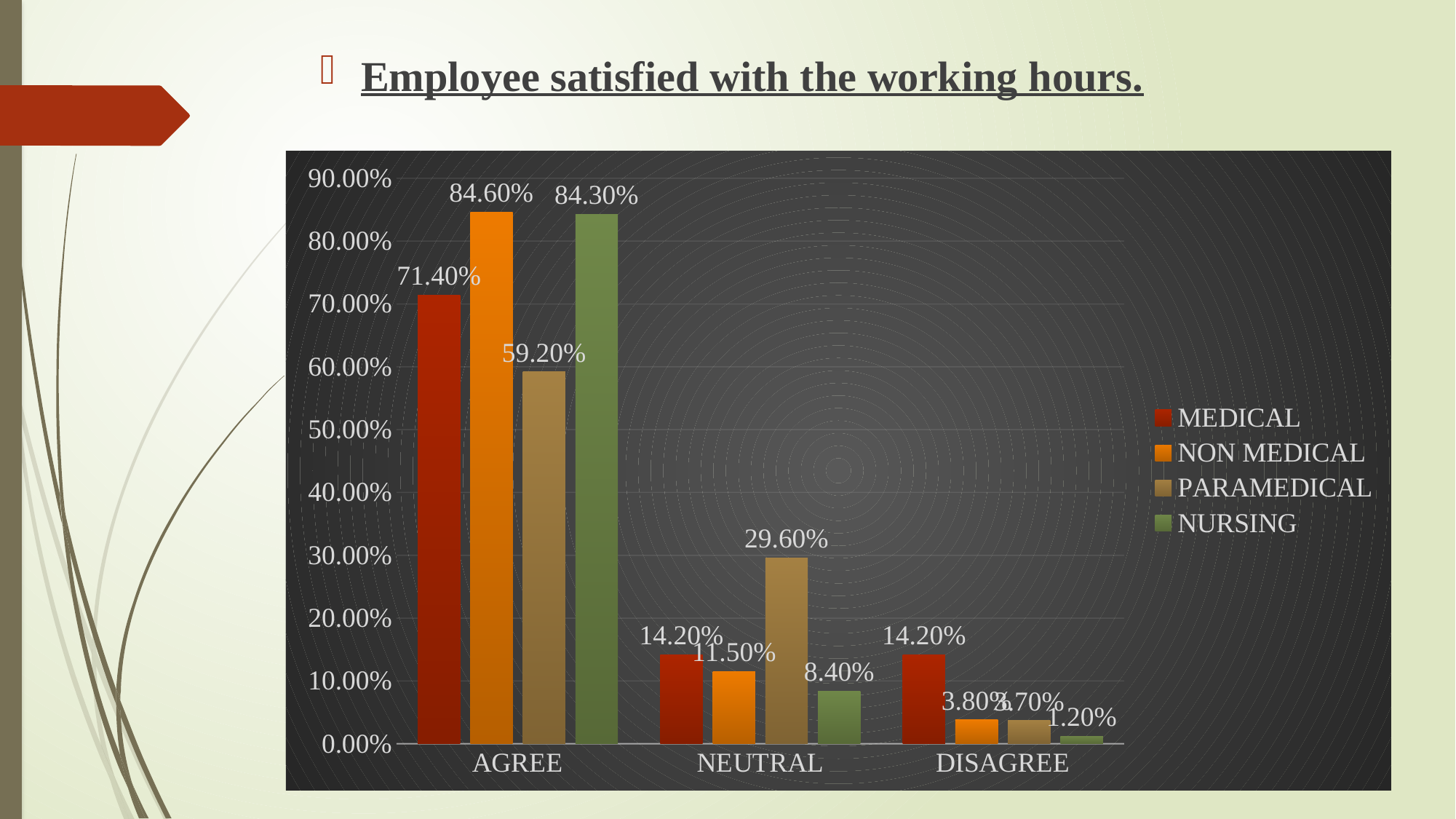
What kind of chart is shown on the slide? bar chart Which series has the lowest value in the AGREE category? PARAMEDICAL What is the difference between the MEDICAL and PARAMEDICAL values in the AGREE category? 12.20% What is the value for NON MEDICAL in the AGREE category? 84.60% Is the value for NURSING in the NEUTRAL category greater or less than 10.00%? less Which series has the highest value in the AGREE category? NON MEDICAL In the NEUTRAL category, which is larger: MEDICAL or NON MEDICAL? MEDICAL How many categories are shown on the x axis? 3 What is the value for NURSING in the DISAGREE category? 1.20% What is the value for PARAMEDICAL in the NEUTRAL category? 29.60% How many series does the legend list? 4 What is the value for MEDICAL in the AGREE category? 71.40%